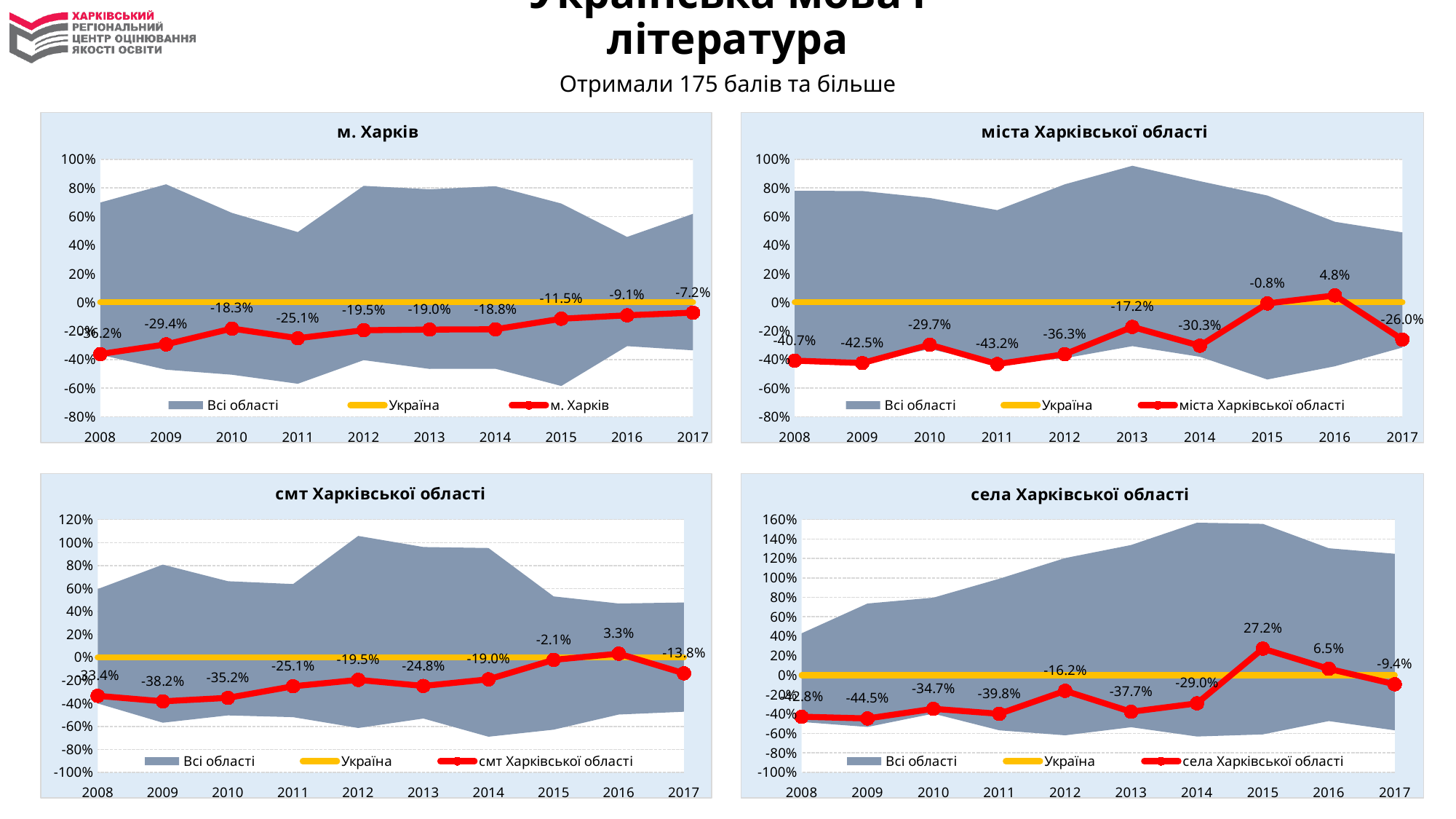
In the chart titled "смт Харківської області", which year has the highest value of the red series? 2016 In the chart titled "міста Харківської області", what is the difference between the red series values for 2016 and 2017? 30.8 percentage points In the chart titled "м. Харків", what is the value of the м. Харків series for 2011? -25.1% In the chart titled "смт Харківської області", what is the value of the red series for 2015? -2.1% In the chart titled "міста Харківської області", which year has the lowest value of the red series? 2011 How many years are shown on the x axis of the chart titled "села Харківської області"? 10 How many series does the legend of the chart titled "смт Харківської області" list? 3 In the chart titled "села Харківської області", what is the value of the red series for 2015? 27.2% In the chart titled "міста Харківської області", what is the value of the red series for 2016? 4.8% In the chart titled "м. Харків", what is the value of the м. Харків series for 2017? -7.2% In the chart titled "м. Харків", does the red series generally rise or fall from 2009 to 2017? rise In the chart titled "села Харківської області", which is larger: the red series value for 2012 or for 2013? 2012